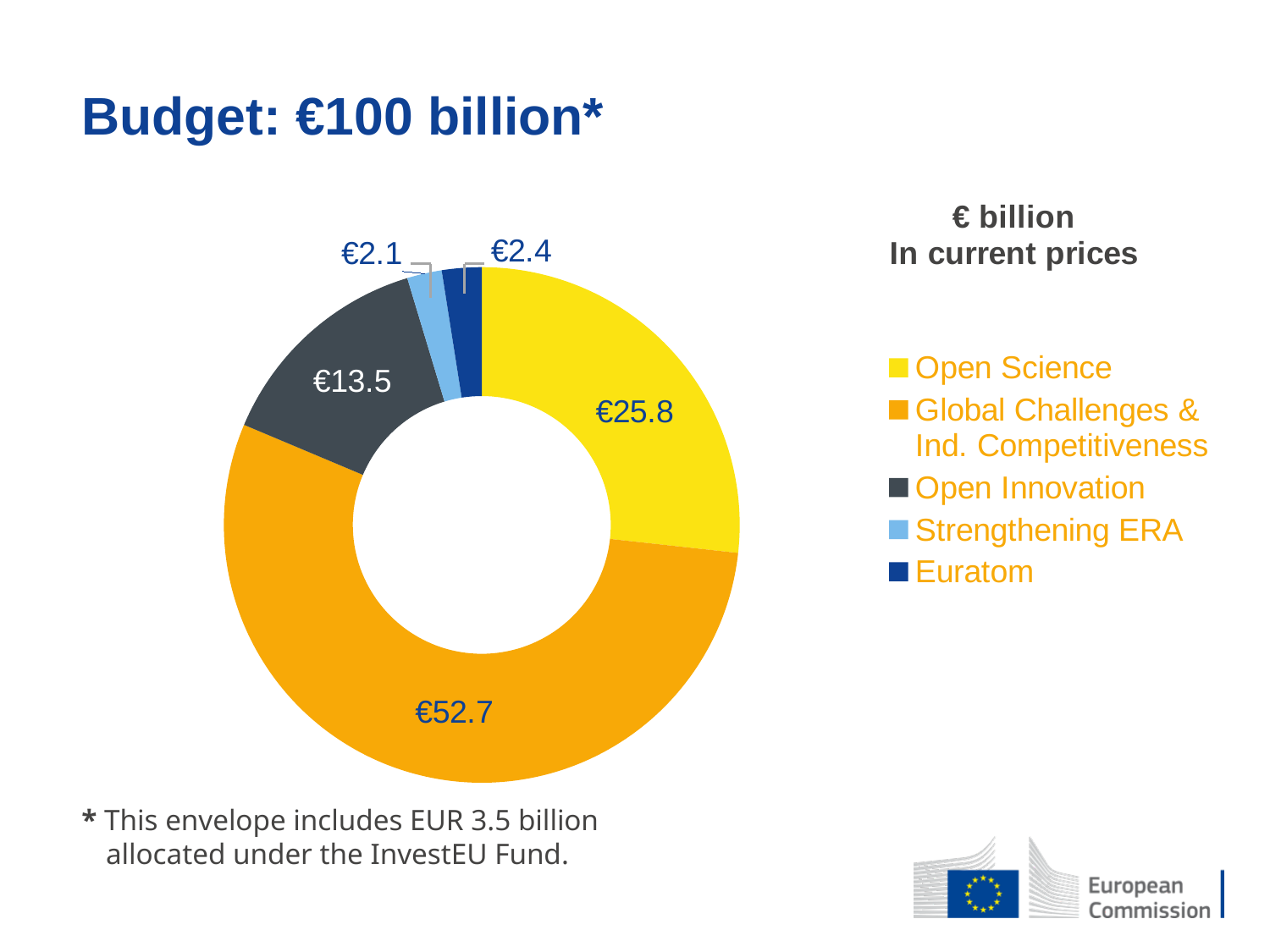
What kind of chart is shown on the slide? doughnut chart What is the difference between Global Challenges & Ind. Competitiveness and Open Science? €26.9 How many categories does the chart show? 5 What is the value for Open Innovation? €13.5 What is the value for Global Challenges & Ind. Competitiveness? €52.7 Which is larger, Euratom or Strengthening ERA? Euratom What is the value for Euratom? €2.4 What is the value for Open Science? €25.8 Which category has the smallest slice? Strengthening ERA What is the difference between Open Science and Open Innovation? €12.3 What is the value for Strengthening ERA? €2.1 Which category has the largest slice? Global Challenges & Ind. Competitiveness